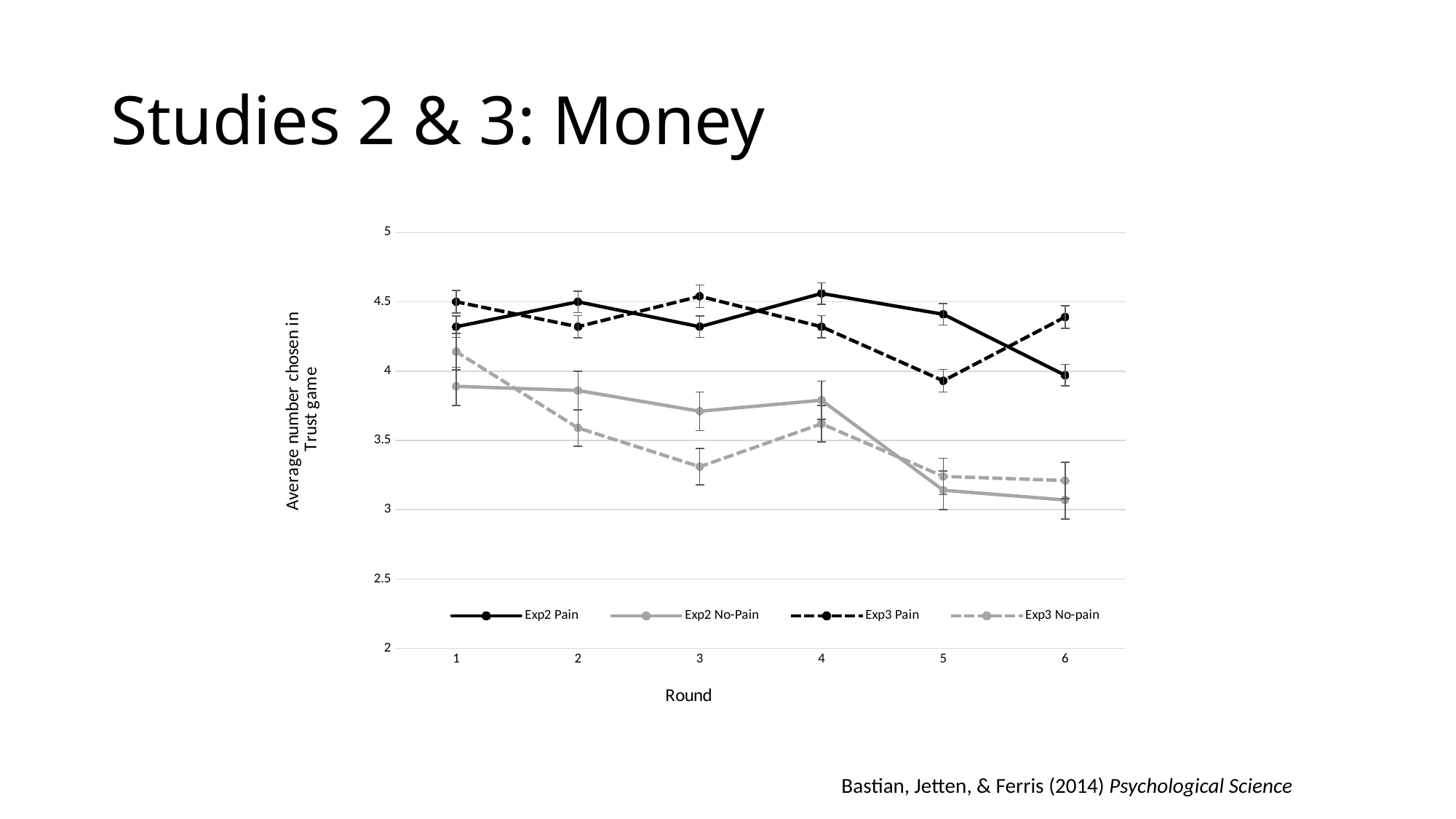
Is the value for Exp2 Pain at round 4 greater or less than 4.5? greater Is the value for Exp2 No-Pain at round 6 greater or less than 3.5? less What kind of chart is shown on the slide? line chart At which round does the Exp2 No-Pain series reach its lowest value? 6 What is the title of the y axis? Average number chosen in Trust game Does the Exp2 No-Pain series generally rise or fall from round 1 to round 6? fall How many rounds are plotted along the x axis? 6 At round 6, which is larger: Exp3 Pain or Exp2 Pain? Exp3 Pain Is the value for Exp3 Pain at round 5 greater or less than 4? less At round 2, which is larger: Exp2 No-Pain or Exp3 No-pain? Exp2 No-Pain How many series does the legend list? 4